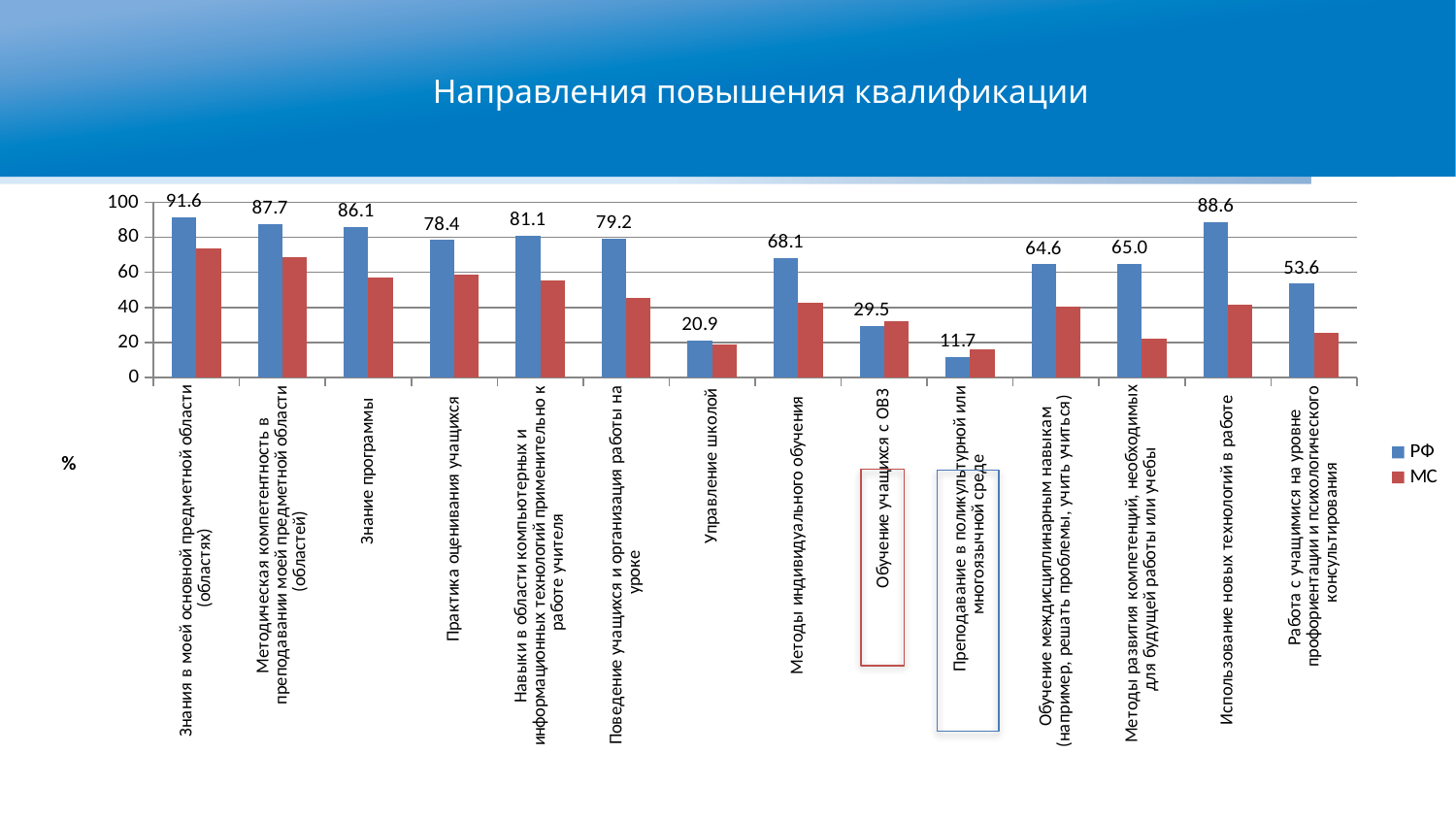
Which is larger: the РФ value for "Методы индивидуального обучения" or for "Работа с учащимися на уровне профориентации и психологического консультирования"? Методы индивидуального обучения What kind of chart is shown on the slide? bar chart Is the МС value for "Знания в моей основной предметной области (областях)" greater or less than 60? greater Which category has the lowest РФ value? Преподавание в поликультурной или многоязычной среде How many categories are shown on the x axis? 14 What is the РФ value for "Использование новых технологий в работе"? 88.6 Which category has the highest РФ value? Знания в моей основной предметной области (областях) What is the РФ value for "Знания в моей основной предметной области (областях)"? 91.6 How many series does the legend list? 2 What is the difference between the РФ values for "Знания в моей основной предметной области (областях)" and "Методическая компетентность в преподавании моей предметной области (областей)"? 3.9 What is the РФ value for "Управление школой"? 20.9